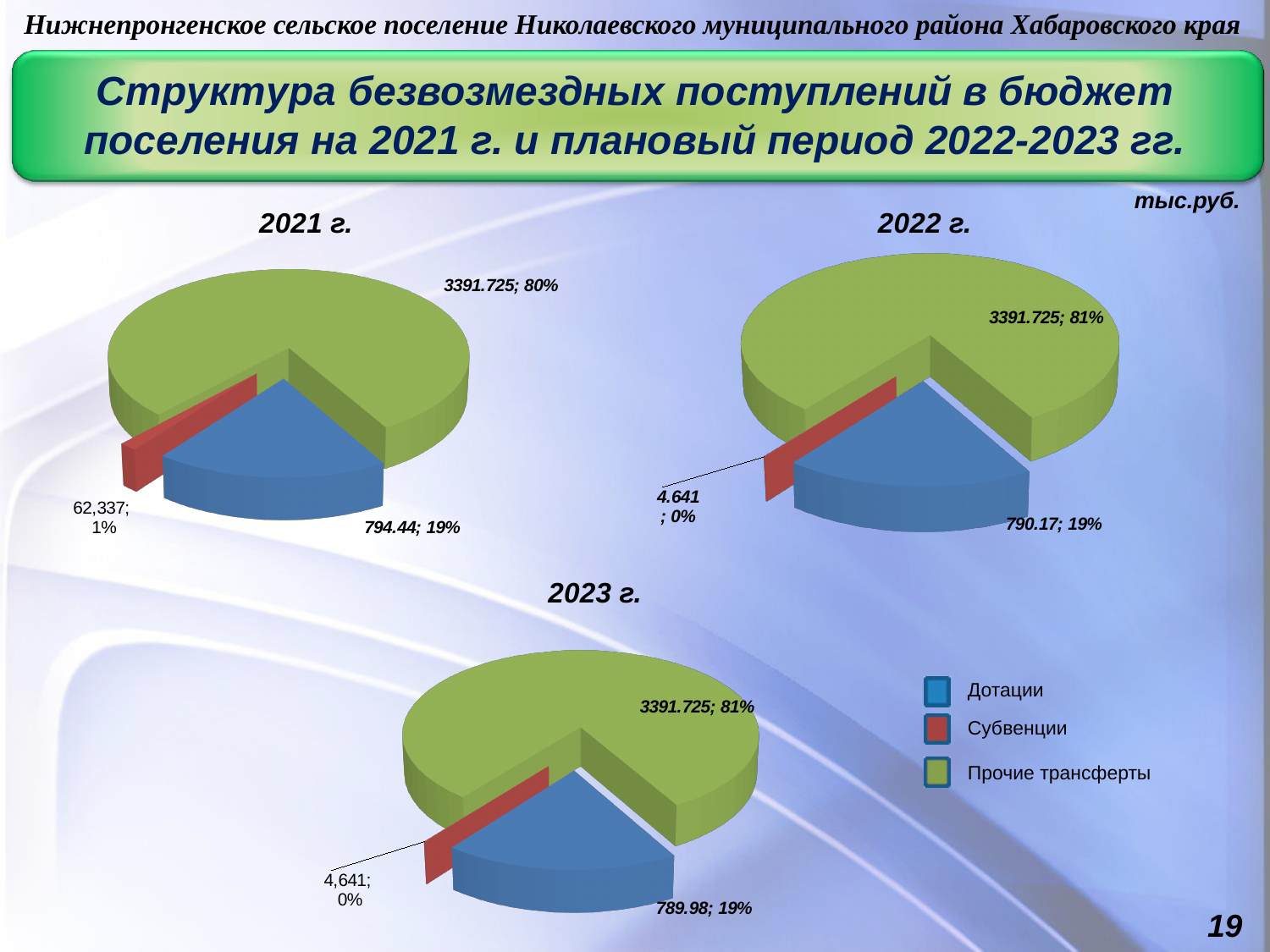
In the 2022 г. pie chart, what share of the pie does Прочие трансферты have? 81% In the 2023 г. pie chart, what value is shown for Дотации? 789.98 In the 2022 г. pie chart, what value is shown for Дотации? 790.17 In the 2022 г. pie chart, what value is shown for Субвенции? 4.641 In the 2021 г. pie chart, what share of the pie does Дотации have? 19% How many categories does the legend list? 3 In the 2023 г. pie chart, which category is the largest? Прочие трансферты In the 2021 г. pie chart, what value is shown for Прочие трансферты? 3391.725 In the 2021 г. pie chart, which category is the smallest? Субвенции In the 2023 г. pie chart, what share of the pie does Субвенции have? 0% What kind of chart is used for 2022 г.? Pie chart In the 2021 г. pie chart, what value is shown for Субвенции? 62,337